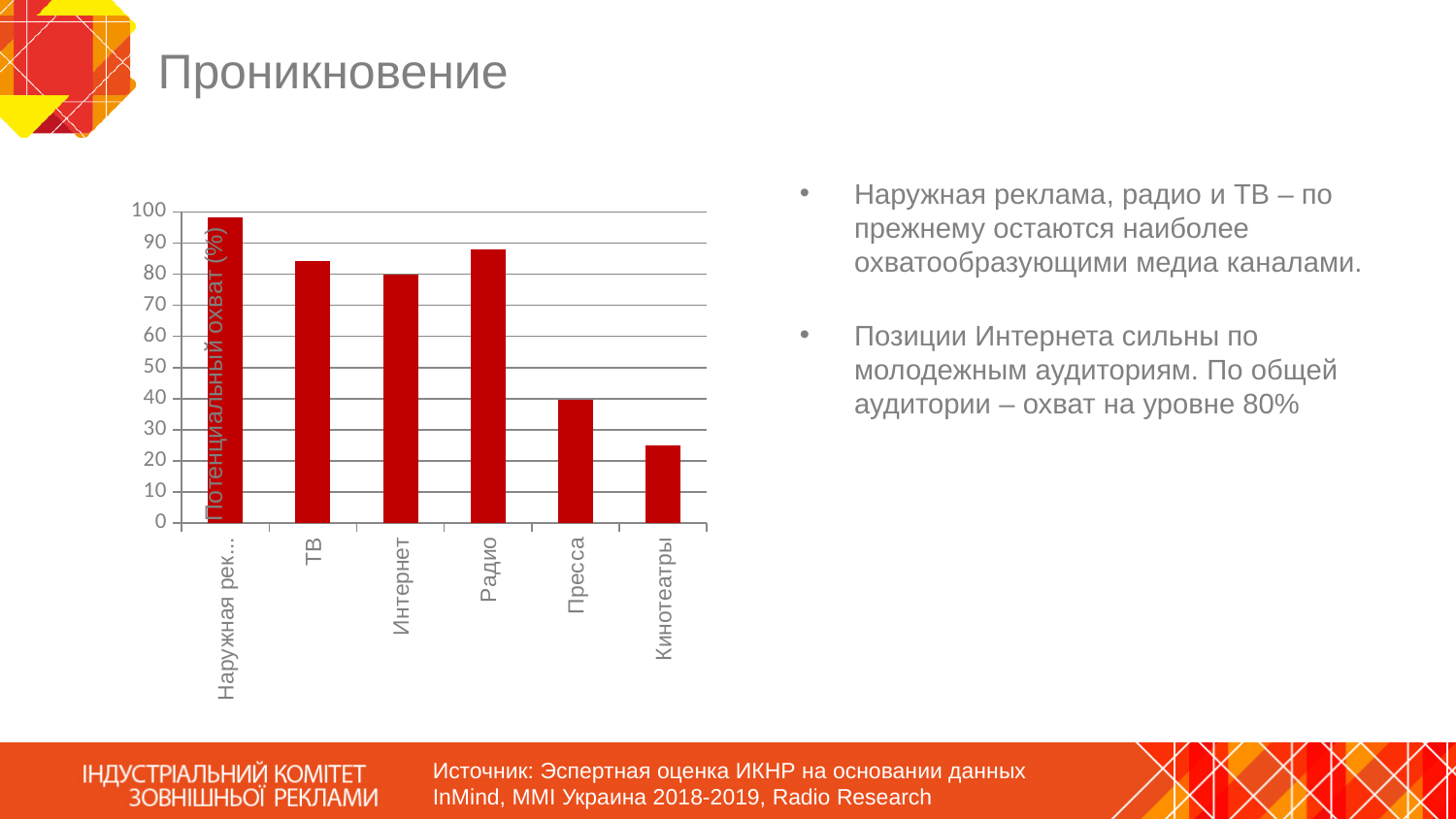
Which is larger, the value for ТВ or the value for Кинотеатры? ТВ Which category has the highest bar in the chart? Наружная рек... (first category) Which is larger, the value for Радио or the value for Пресса? Радио What kind of chart is shown on the slide? bar chart Is the value for Пресса greater or less than 50? less Is the value for Кинотеатры greater or less than 20? greater Which category has the lowest bar in the chart? Кинотеатры Is the value for Радио greater or less than 90? less How many categories are shown on the x axis of the chart? 6 What is the label of the vertical axis of the chart? Потенциальный охват (%) What is the value for Интернет in the chart? 80